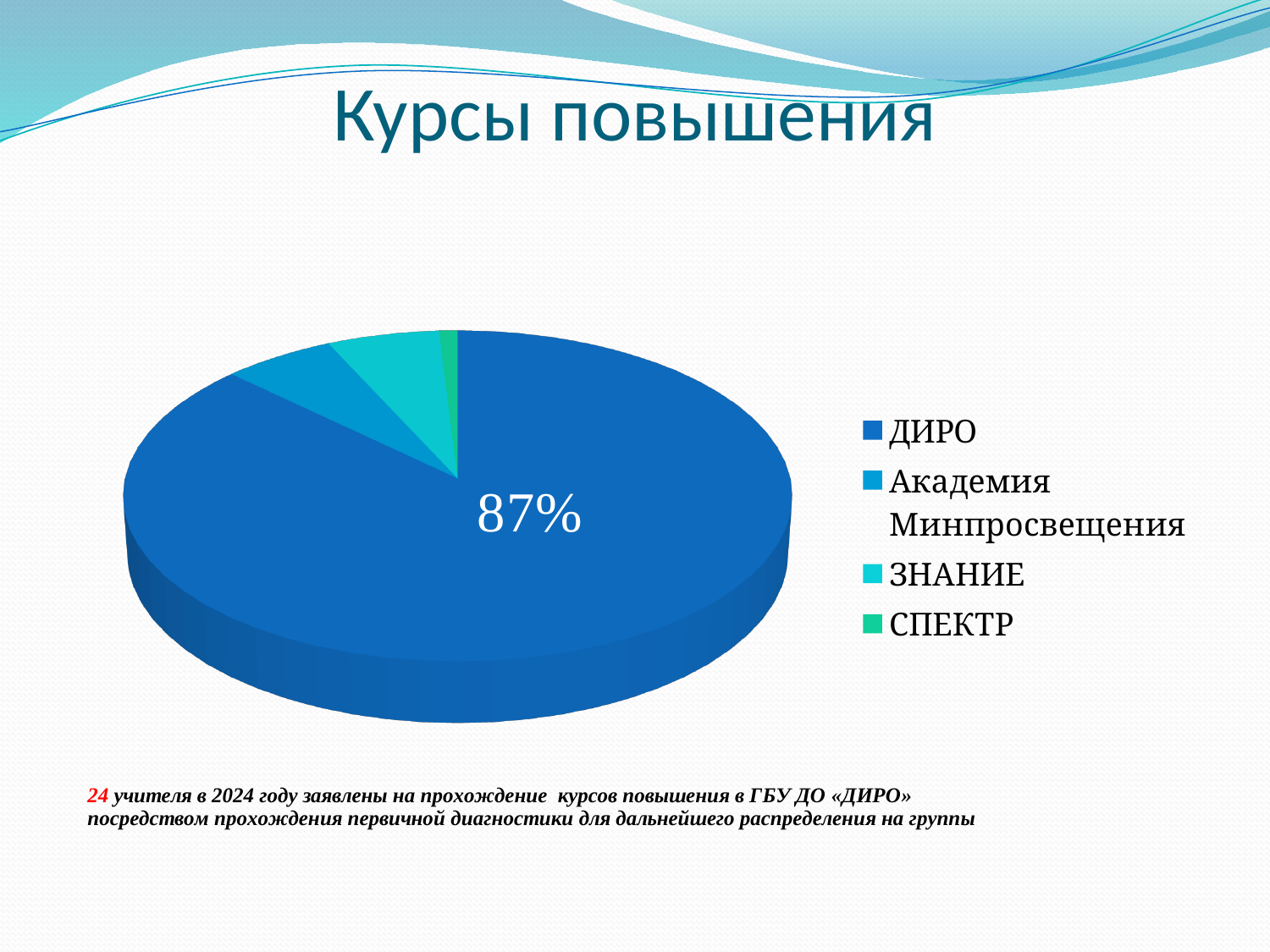
Which legend entry is listed second in the pie chart's legend? Академия Минпросвещения How many slices does the pie chart have? 4 How many entries does the legend of the pie chart list? 4 What share of the pie does ДИРО account for? 87% Which slice is larger, ДИРО or ЗНАНИЕ? ДИРО What is the title of the chart on the slide? Курсы повышения Which category has the smallest slice in the pie chart? СПЕКТР What kind of chart is shown on the slide? pie chart Which slice is larger, Академия Минпросвещения or СПЕКТР? Академия Минпросвещения Which category has the largest slice in the pie chart? ДИРО What value is printed on the ДИРО slice of the pie chart? 87%